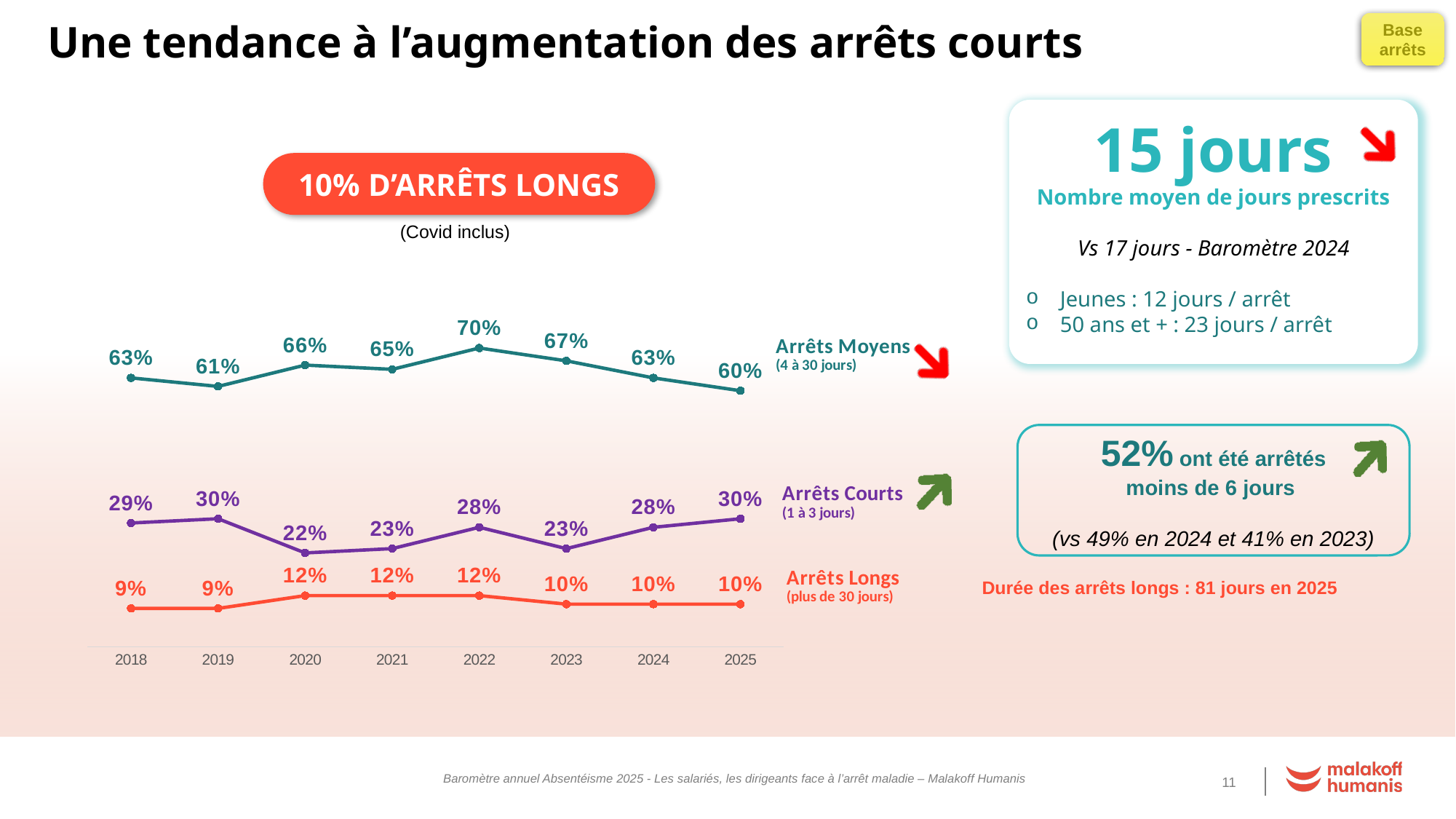
What duration range is given for Arrêts Courts in the series label? 1 à 3 jours What kind of chart is shown on the slide? Line chart In which year is the Arrêts Moyens series at its lowest? 2025 Which is larger: Arrêts Courts in 2025 or Arrêts Courts in 2023? Arrêts Courts in 2025 What is the value for Arrêts Longs in 2021? 12% Does the Arrêts Moyens series rise or fall between 2022 and 2025? Fall In which year is the Arrêts Moyens series at its highest? 2022 What is the value for Arrêts Courts in 2020? 22% What is the value for Arrêts Moyens in 2022? 70% How many years are shown on the x axis? 8 What is the difference between the Arrêts Moyens value in 2022 and in 2025? 10 percentage points How many series are plotted on the chart? 3